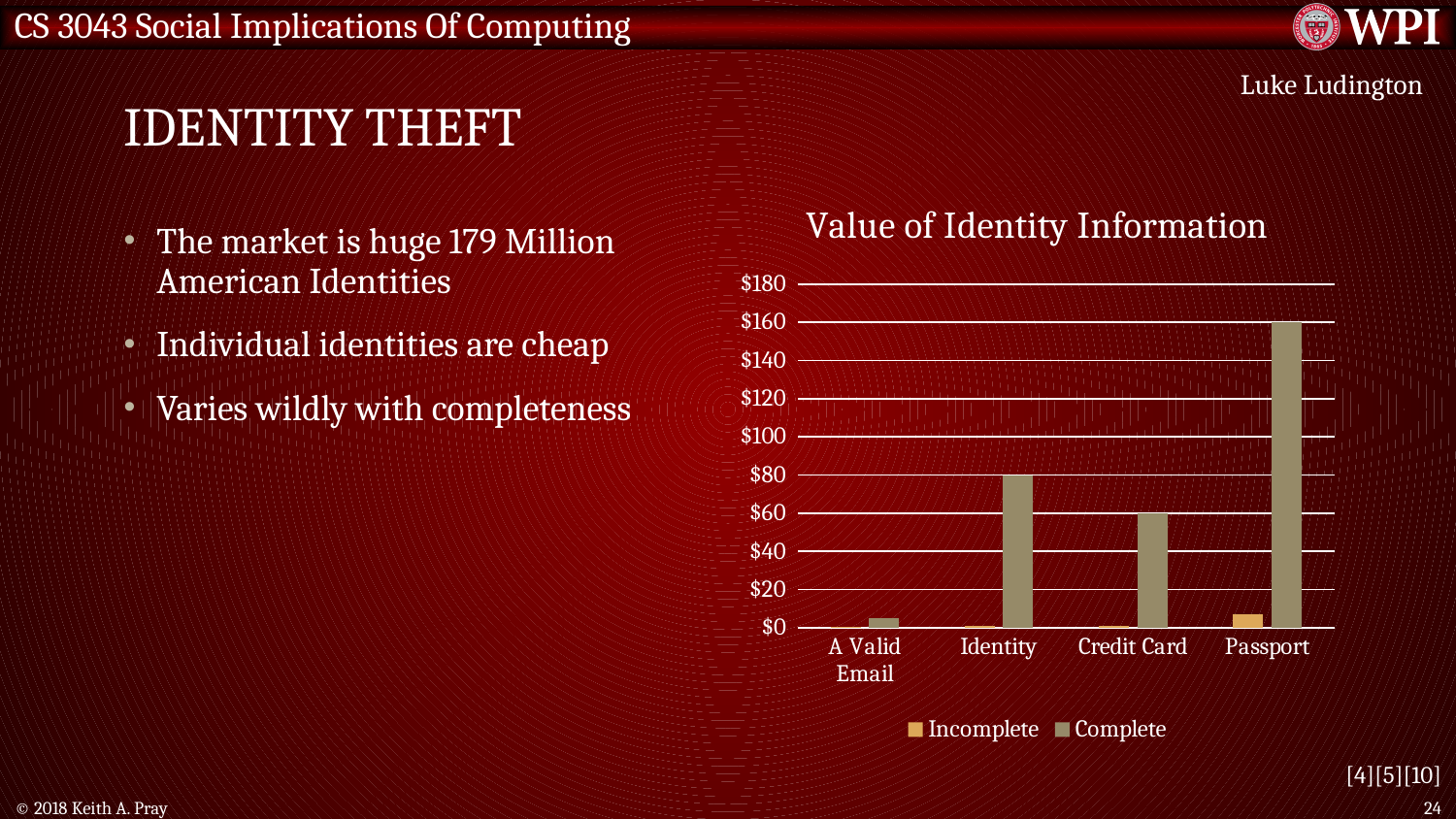
Which has a larger Complete value, Identity or Credit Card? Identity How many series does the chart's legend list? 2 Is the Complete value for Credit Card greater or less than $40? greater Is the Complete value for Passport greater or less than $140? greater For Passport, which series has the larger value, Incomplete or Complete? Complete Is the Complete value for A Valid Email greater or less than $20? less What kind of chart is shown on the slide? bar chart What are the two series named in the legend? Incomplete and Complete How many categories are shown on the x axis of the chart? 4 Which category has the lowest Complete value? A Valid Email Which category has the highest Complete value? Passport What is the title of the chart? Value of Identity Information